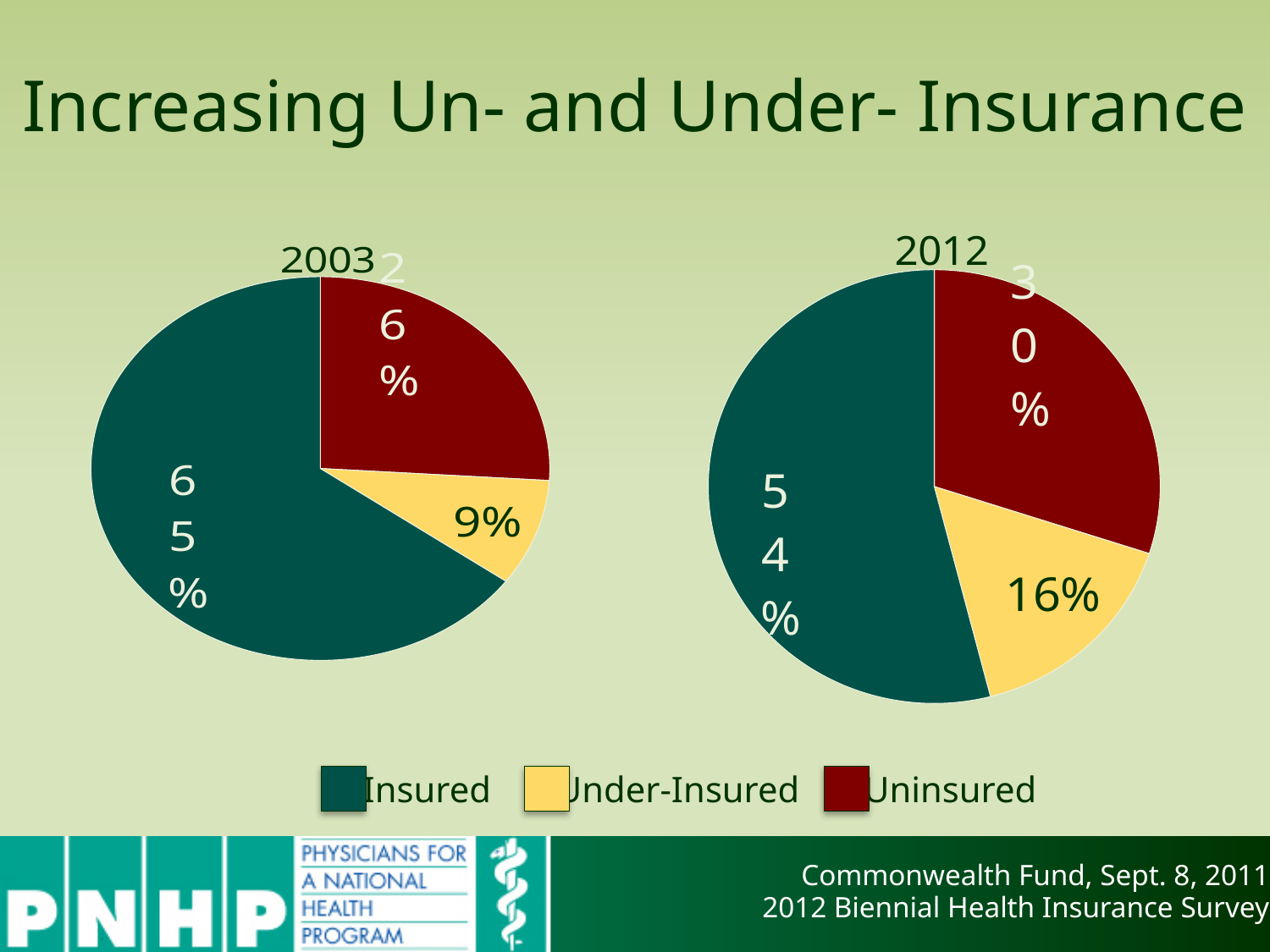
In the 2012 pie chart, what is the value for Insured? 54% In the 2012 pie chart, what is the value for Under-Insured? 16% In the 2012 pie chart, which category has the smallest slice? Under-Insured In the 2003 pie chart, which category has the largest slice? Insured In the 2003 pie chart, what is the value for Under-Insured? 9% What is the difference between the Under-Insured value in the 2012 pie chart and the Under-Insured value in the 2003 pie chart? 7% How many categories does the legend list? 3 What kind of chart is used on this slide? Pie chart In the 2003 pie chart, what is the value for Insured? 65% In the 2003 pie chart, which category has the smallest slice? Under-Insured In the 2012 pie chart, what is the value for Uninsured? 30% Which is larger: the Insured value in the 2003 pie chart or the Insured value in the 2012 pie chart? 2003